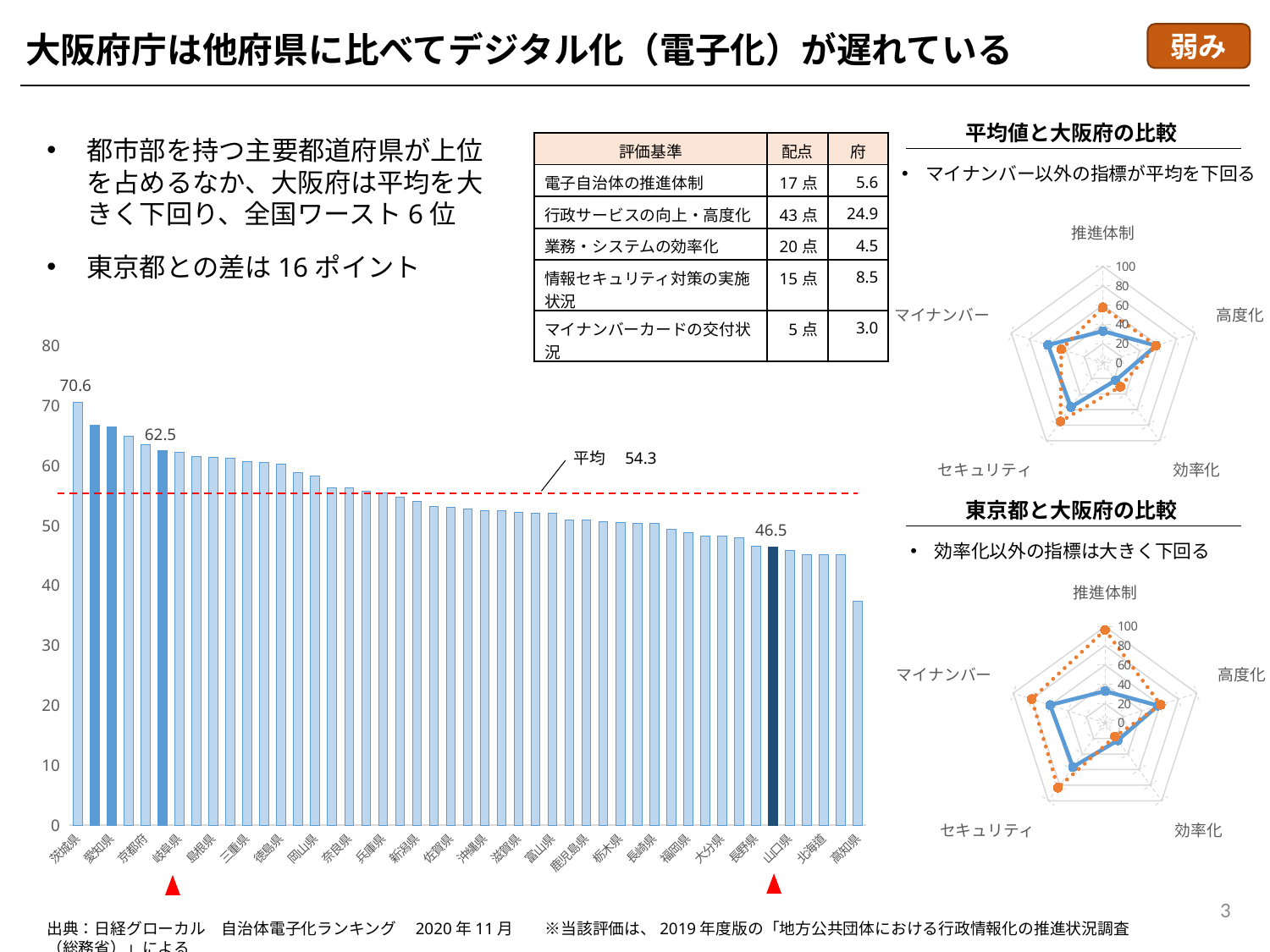
In the bar chart, which is larger: the bar labelled 70.6 or the bar labelled 62.5? 70.6 In the bar chart, what is the highest value shown? 70.6 What kind of chart is the large chart on the left of the slide? Bar chart In the bar chart, is the value of the dark navy highlighted bar greater or less than 50? less How many axes (indicators) does the radar chart titled 平均値と大阪府の比較 have? 5 In the bar chart, what value is labelled on the dark navy highlighted bar? 46.5 What kind of chart is used in the two charts on the right side of the slide (平均値と大阪府の比較 and 東京都と大阪府の比較)? Radar chart In the bar chart, what is the difference between the bar labelled 62.5 and the bar labelled 46.5? 16 In the bar chart, do the values rise or fall from left to right? Fall In the bar chart, what is the value of the average (平均) shown by the dashed red line? 54.3 In the bar chart, is the value of the first (leftmost) bar greater or less than 70? greater In the bar chart, is the value of the last (rightmost) bar greater or less than 40? less